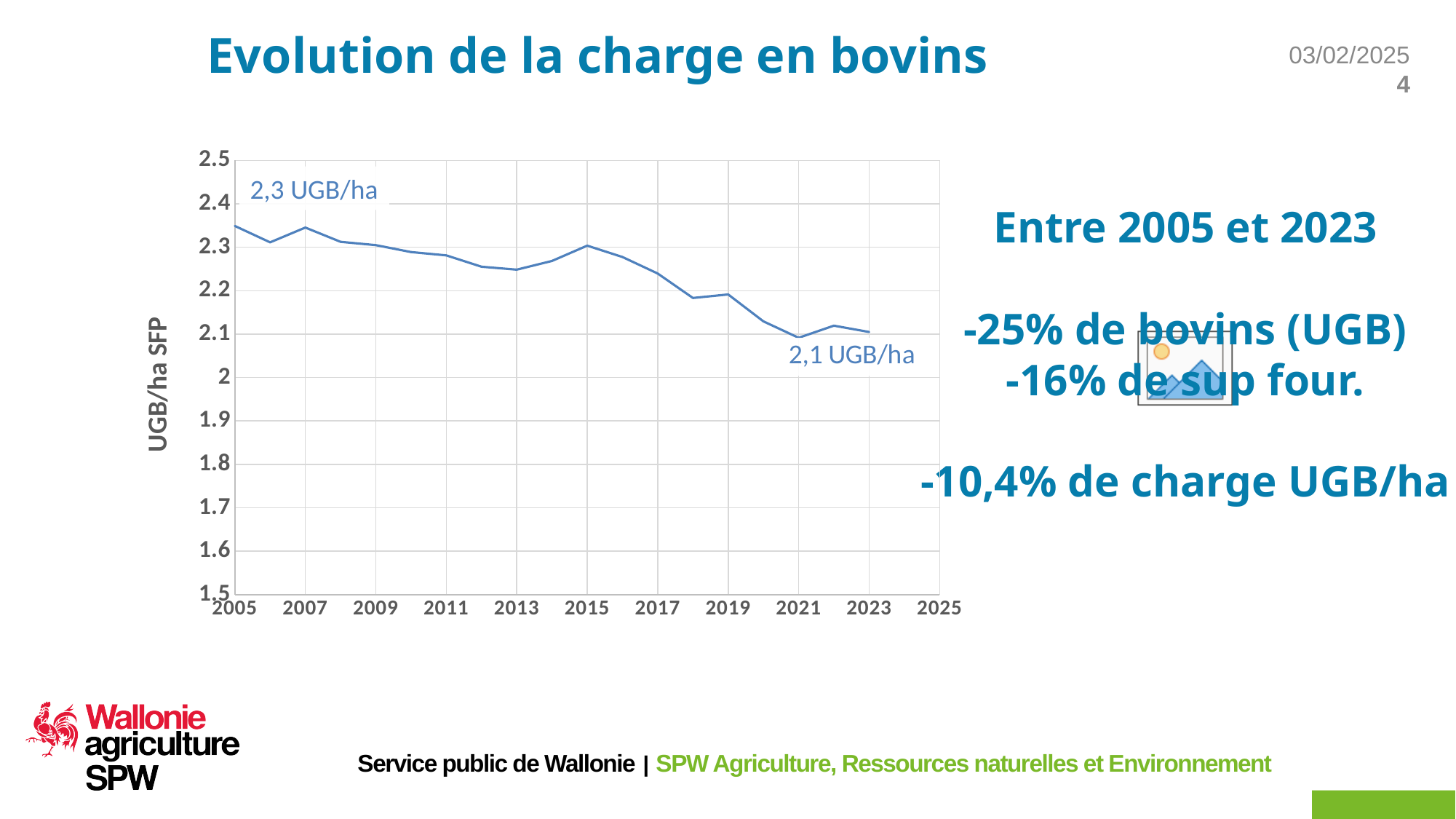
What is the label on the vertical axis of the chart? UGB/ha SFP Is the value for 2013 greater or less than 2.2? greater What value is annotated at the start of the line, in 2005? 2,3 UGB/ha What kind of chart is shown on the slide? line chart What is the title of the chart? Evolution de la charge en bovins Overall, do the values rise or fall from 2005 to 2023? fall What value is annotated at the end of the line, in 2023? 2,1 UGB/ha Which year has the larger value, 2015 or 2019? 2015 Is the value for 2007 greater or less than 2.3? greater Is the value for 2005 greater or less than 2.3? greater Which year has the larger value, 2005 or 2023? 2005